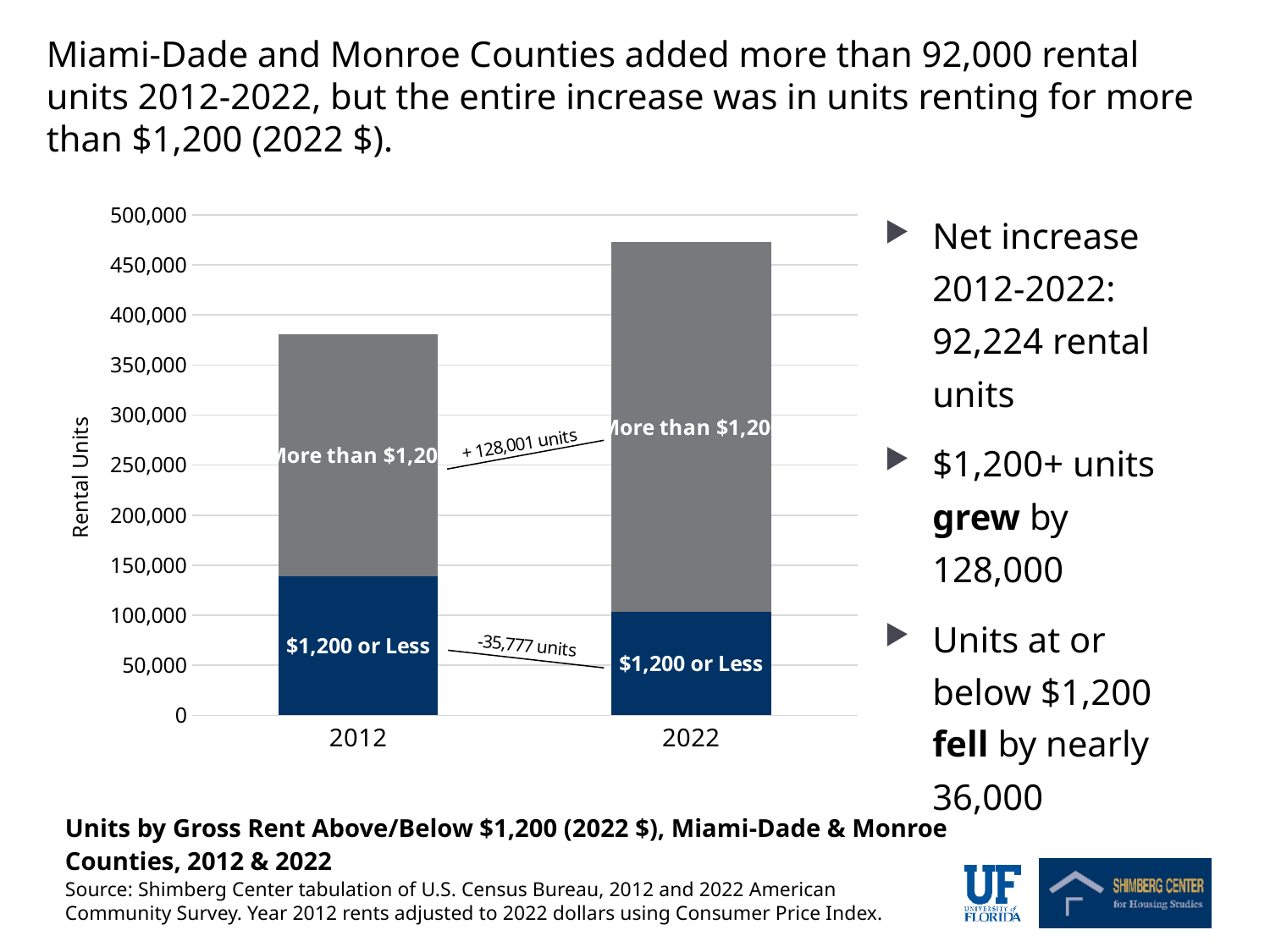
Which year has the taller total bar, 2012 or 2022? 2022 Is the total height of the 2012 bar greater or less than 400,000? less What is the label on the vertical axis of the chart? Rental Units Is the total height of the 2022 bar greater or less than 450,000? greater Does the total number of rental units rise or fall from 2012 to 2022? Rise Is the '$1,200 or Less' segment for 2012 greater or less than 150,000? less Which two years are compared in the chart? 2012 and 2022 According to the annotation on the chart, by how many units did the '$1,200 or Less' segment change from 2012 to 2022? -35,777 units How many years (categories) are shown on the x axis of the chart? 2 What kind of chart is shown on the slide? Stacked bar chart According to the annotation on the chart, by how many units did the 'More than $1,200' segment change from 2012 to 2022? +128,001 units